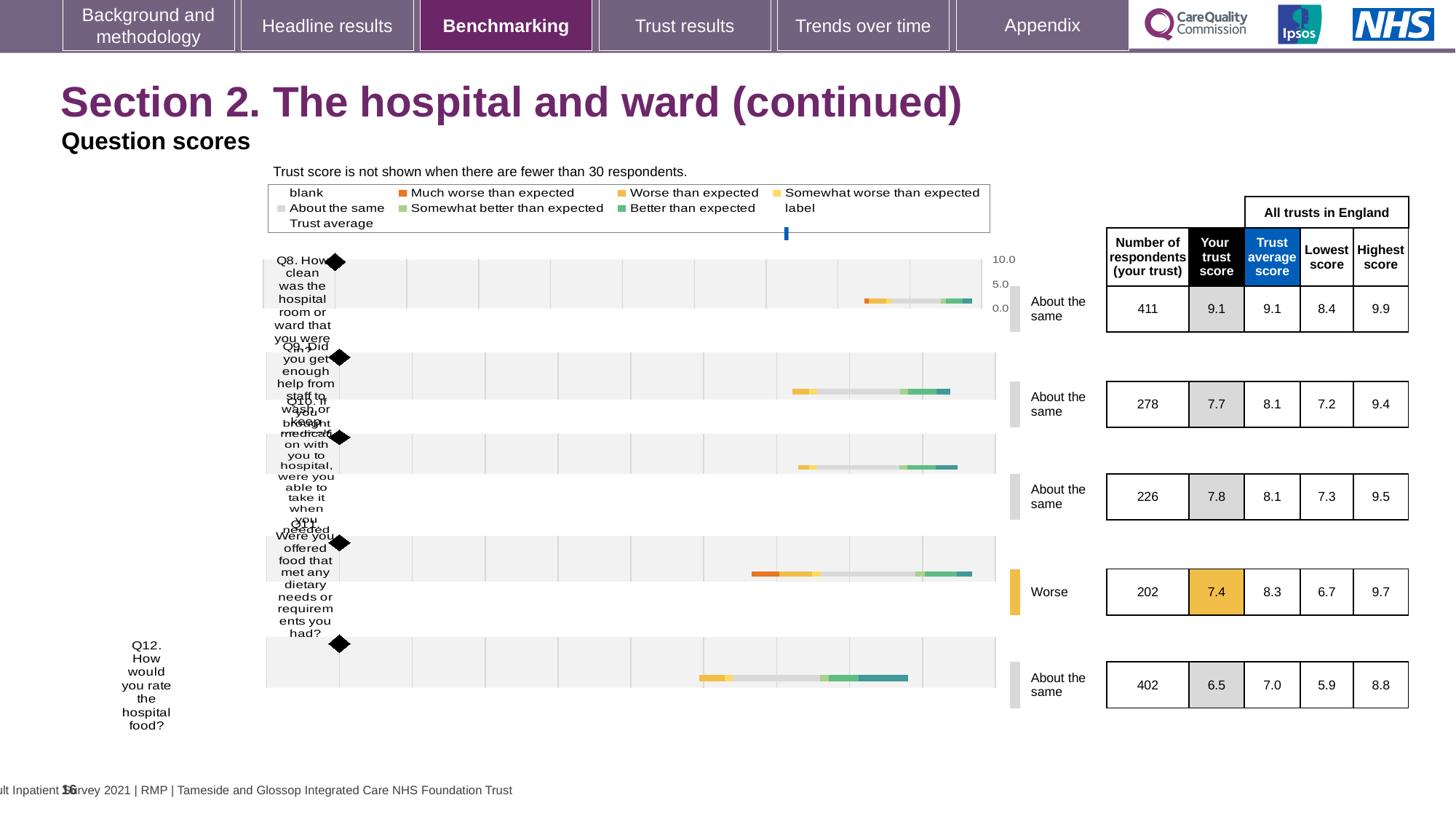
Which question has the lowest 'Your trust score'? Q12 How many questions (categories) are plotted in the chart? 5 For Q11, what is the difference between the trust average score and the trust's own score? 0.9 Which question has the highest 'Your trust score'? Q8 For Q8, what is the difference between the highest and lowest scores across all trusts in England? 1.5 What kind of chart is used to show the question scores on this slide? bar chart According to the note above the chart, when is the trust score not shown? When there are fewer than 30 respondents For Q9, which is larger: the trust's score or the trust average score? Trust average score How many respondents from the trust answered Q12 (how would you rate the hospital food)? 402 What is the highest score across all trusts in England for Q10? 9.5 What is the trust's score for Q8 (how clean was the hospital room or ward)? 9.1 Which question is rated 'Worse' rather than 'About the same'? Q11